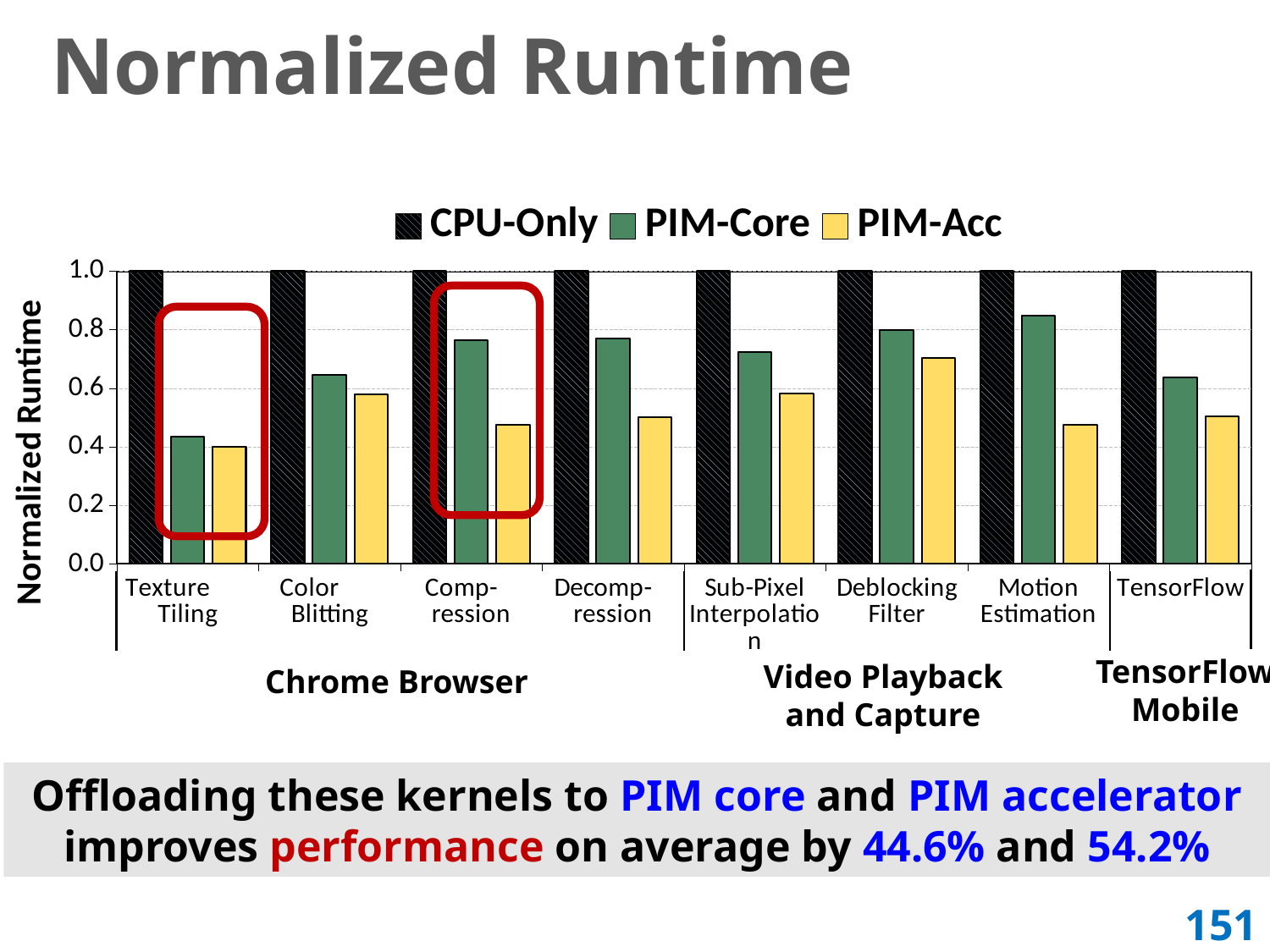
Which category has the lowest PIM-Core normalized runtime? Texture Tiling For Compression, which is larger: the PIM-Core value or the PIM-Acc value? PIM-Core What is the CPU-Only normalized runtime for Texture Tiling? 1.0 What is the label on the y axis of the chart? Normalized Runtime Is the PIM-Core value for Texture Tiling greater or less than 0.6? less Which category has the highest PIM-Core normalized runtime? Motion Estimation How many kernel categories are plotted along the x axis? 8 Is the PIM-Acc value for Compression greater or less than 0.6? less What kind of chart is shown on the slide? bar chart Which category has the highest PIM-Acc normalized runtime? Deblocking Filter Is the PIM-Acc value for Deblocking Filter greater or less than 0.6? greater How many series does the legend list? 3